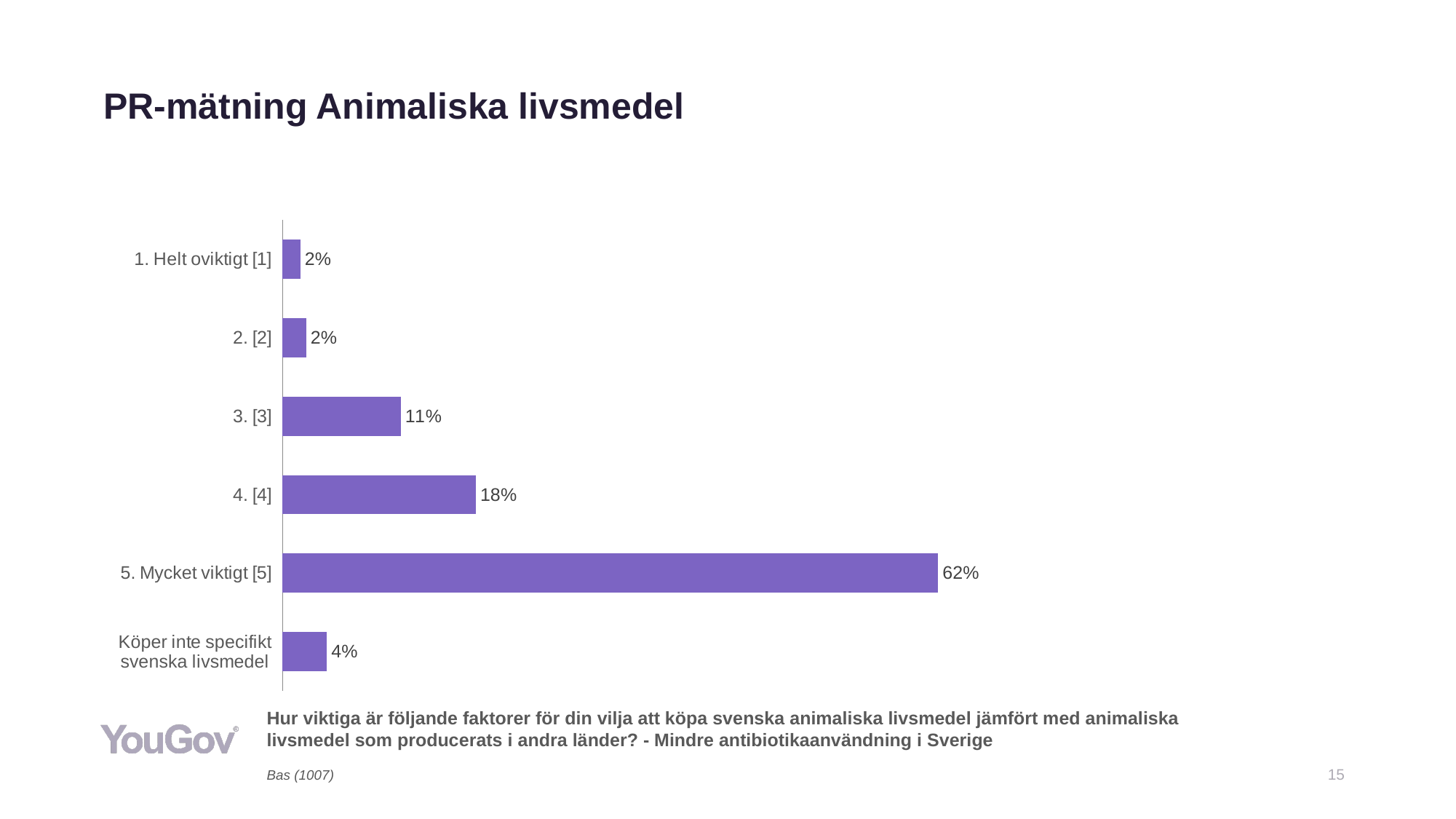
What is the value for "5. Mycket viktigt [5]"? 62% What is the value for "Köper inte specifikt svenska livsmedel"? 4% What is the base (Bas) shown below the chart? 1007 How many categories are shown in the chart? 6 What is the difference between the values for "4. [4]" and "3. [3]"? 7% What is the difference between the values for "5. Mycket viktigt [5]" and "4. [4]"? 44% What is the value for "3. [3]"? 11% What is the combined value of "1. Helt oviktigt [1]" and "2. [2]"? 4% Which is larger, the value for "3. [3]" or the value for "Köper inte specifikt svenska livsmedel"? 3. [3] What is the value for "4. [4]"? 18% What kind of chart is shown on the slide? Bar chart Which category has the highest value? 5. Mycket viktigt [5]